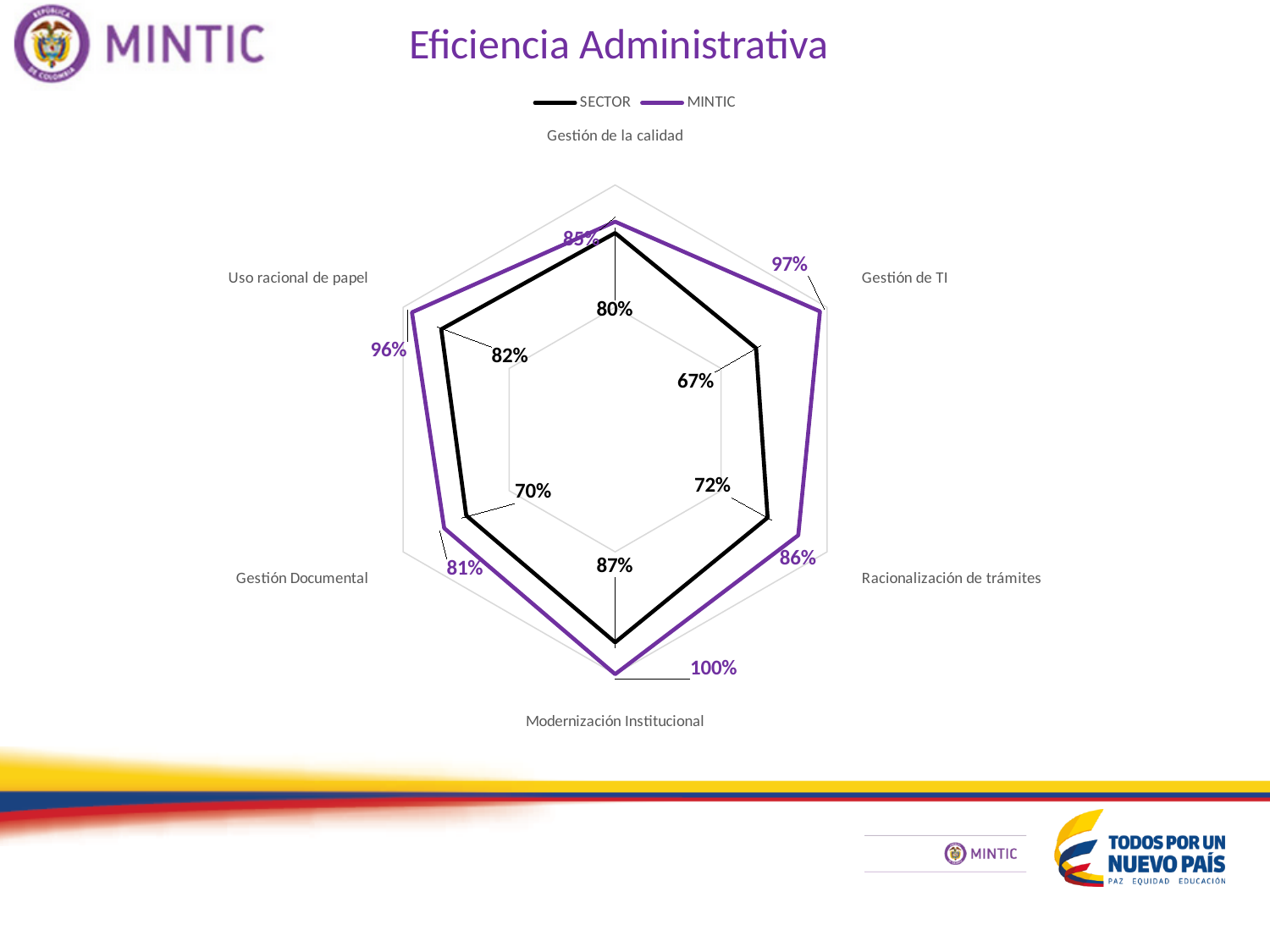
What is the title of the chart? Eficiencia Administrativa Which category has the highest MINTIC value? Modernización Institucional What is the SECTOR value for Gestión Documental? 70% What is the SECTOR value for Gestión de TI? 67% What kind of chart is shown on the slide? Radar chart Which category has the lowest SECTOR value? Gestión de TI How many series does the legend list? 2 For Racionalización de trámites, which series has the larger value, SECTOR or MINTIC? MINTIC What is the difference between the MINTIC and SECTOR values for Uso racional de papel? 14% How many categories (axes) does the radar chart have? 6 What is the MINTIC value for Gestión de TI? 97% What is the MINTIC value for Modernización Institucional? 100%